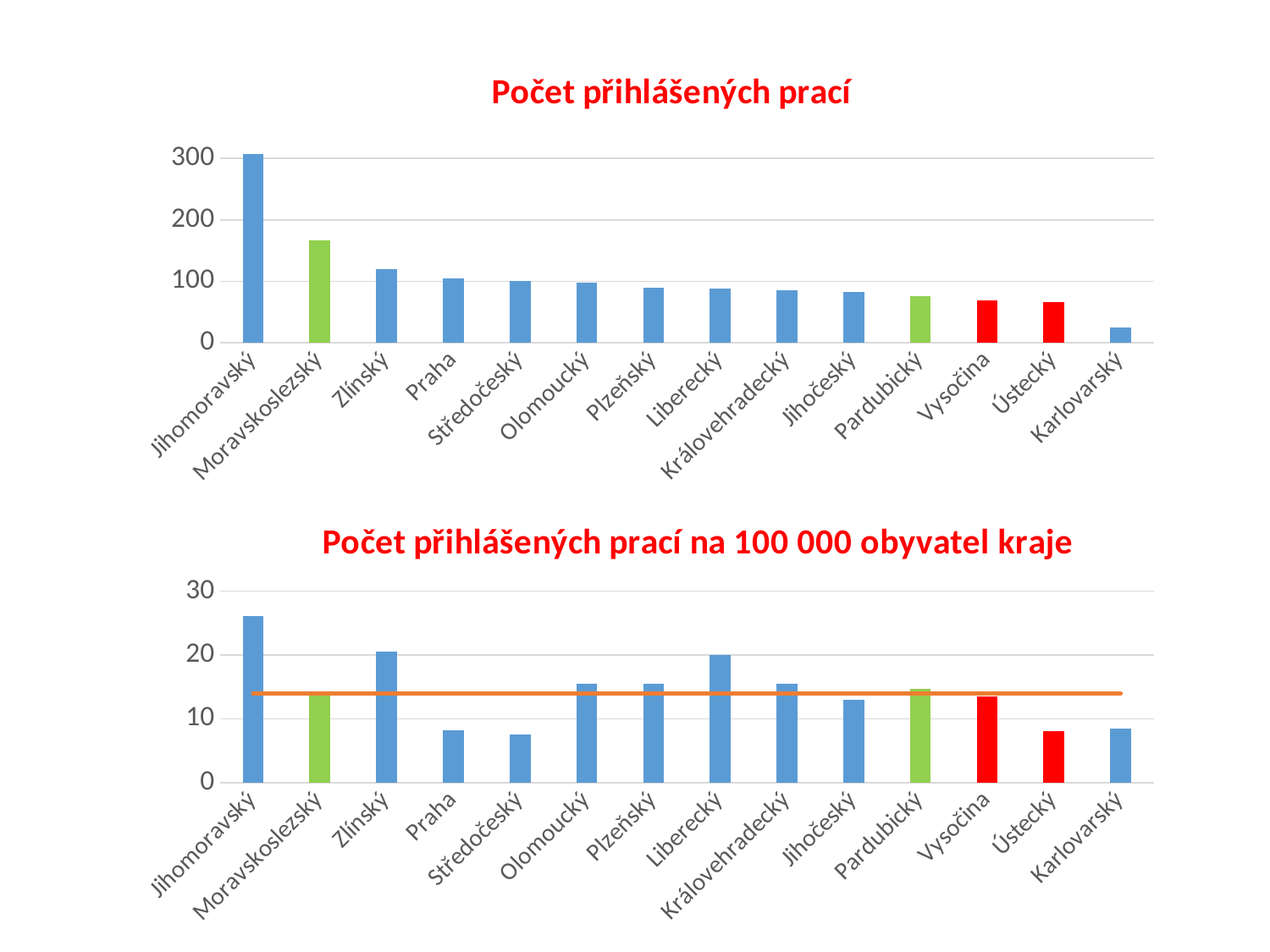
In the top chart 'Počet přihlášených prací', which is larger, the value for Zlínský or the value for Pardubický? Zlínský In the bottom chart 'Počet přihlášených prací na 100 000 obyvatel kraje', which region has the highest value? Jihomoravský In the top chart 'Počet přihlášených prací', is the value for Karlovarský greater or less than 100? less In the bottom chart 'Počet přihlášených prací na 100 000 obyvatel kraje', is the value for Praha greater or less than 10? less In the top chart 'Počet přihlášených prací', which region has the lowest value? Karlovarský In the top chart 'Počet přihlášených prací', is the value for Moravskoslezský greater or less than 100? greater How many regions are shown on the x axis of the top chart 'Počet přihlášených prací'? 14 In the top chart 'Počet přihlášených prací', do the values rise or fall from left to right along the x axis? fall What kind of chart is the bottom chart 'Počet přihlášených prací na 100 000 obyvatel kraje'? combination bar and line chart (bars with a horizontal line) In the top chart 'Počet přihlášených prací', which region has the highest value? Jihomoravský In the bottom chart 'Počet přihlášených prací na 100 000 obyvatel kraje', which is larger, the value for Zlínský or the value for Středočeský? Zlínský In the bottom chart, which two regions are drawn with red bars? Vysočina and Ústecký